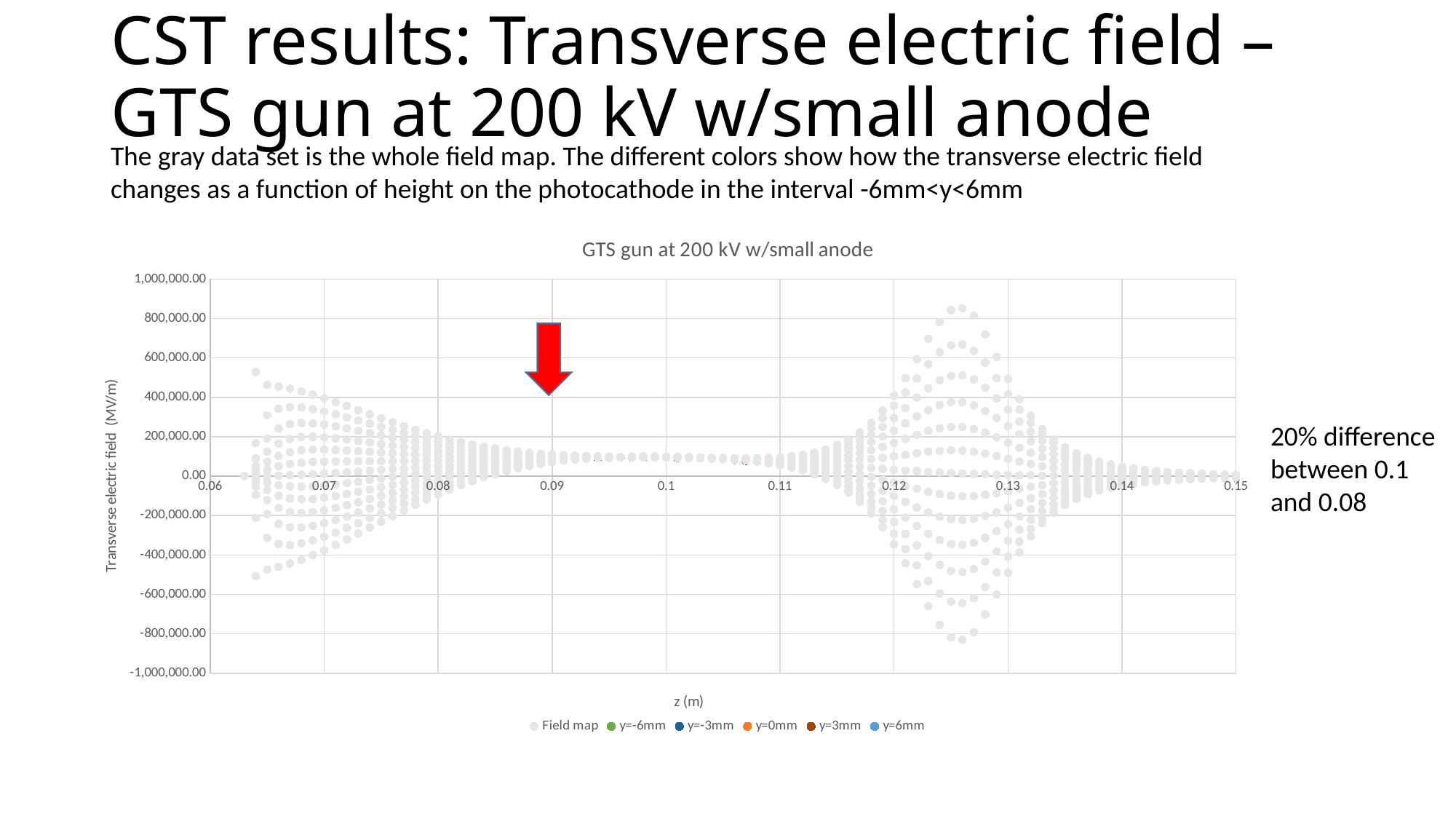
Is the highest Field map value plotted near z = 0.065 greater or less than 400,000.00? greater Is the highest Field map value plotted near z = 0.1 greater or less than 200,000.00? less Around which x-axis value does the Field map series reach its largest spread of values, 0.09 or 0.125? 0.125 What is the maximum value shown on the y axis of the chart? 1,000,000.00 Is the lowest value plotted in the Field map series greater or less than -800,000.00? less What kind of chart is shown on the slide? Scatter chart How many series does the chart legend list? 6 What is the title of the chart? GTS gun at 200 kV w/small anode What is the label of the x axis of the chart? z (m)